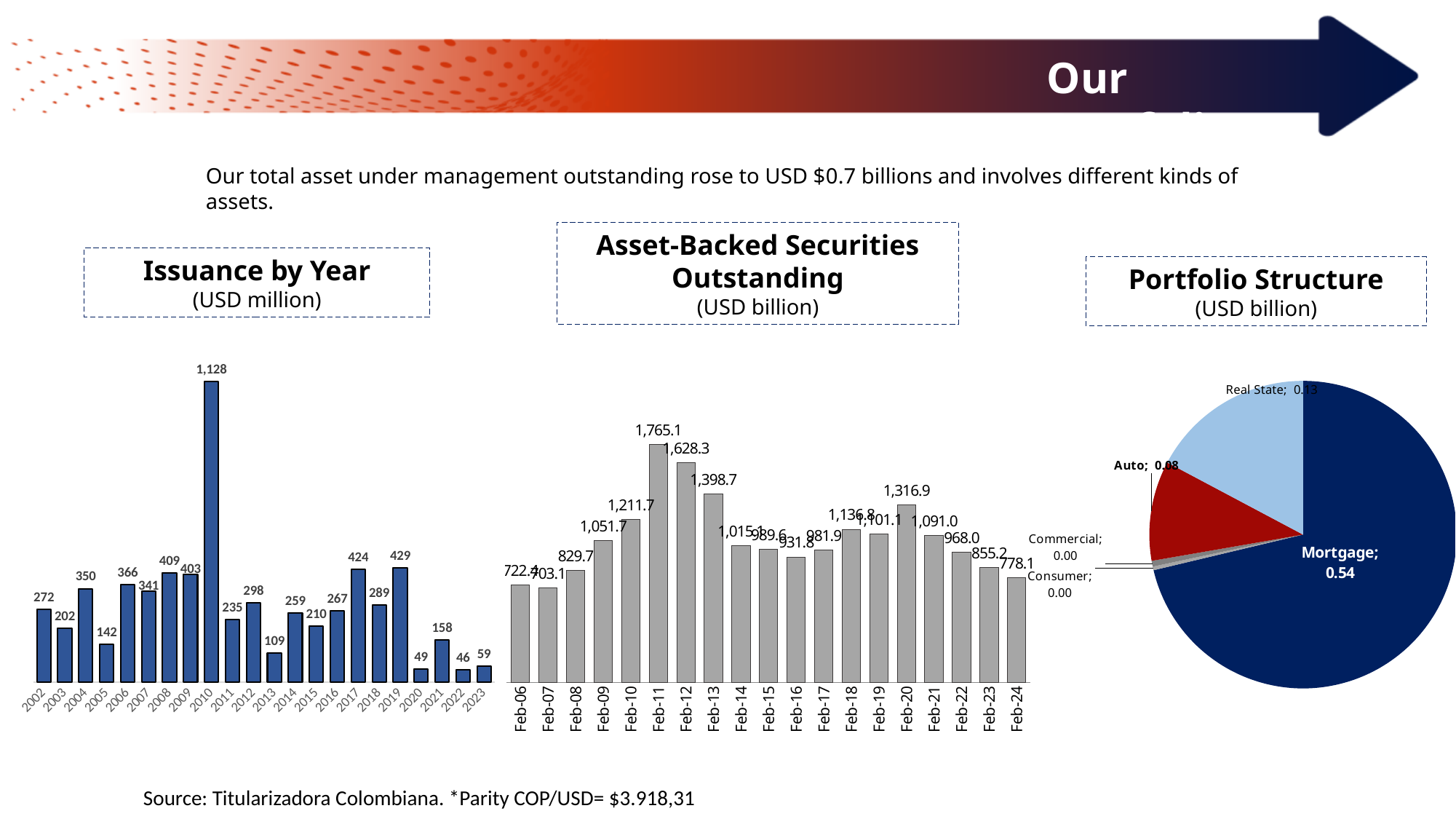
In the Asset-Backed Securities Outstanding chart, what is the value for Feb-11? 1,765.1 In the Issuance by Year chart, how many years are shown? 22 In the Issuance by Year chart, what is the difference between the 2019 and 2017 values? 5 In the Asset-Backed Securities Outstanding chart, what is the difference between Feb-11 and Feb-12? 136.8 In the Issuance by Year chart, which year had the lowest issuance? 2022 In the Issuance by Year chart, what was the issuance in 2010? 1,128 In the Portfolio Structure pie chart, what is the value for Mortgage? 0.54 What type of chart is the Portfolio Structure chart? Pie chart In the Issuance by Year chart, which year had the highest issuance? 2010 In the Asset-Backed Securities Outstanding chart, how many periods are plotted? 19 In the Asset-Backed Securities Outstanding chart, which period has the lowest value? Feb-07 In the Asset-Backed Securities Outstanding chart, is the value for Feb-20 larger or smaller than the value for Feb-21? Feb-20 is larger